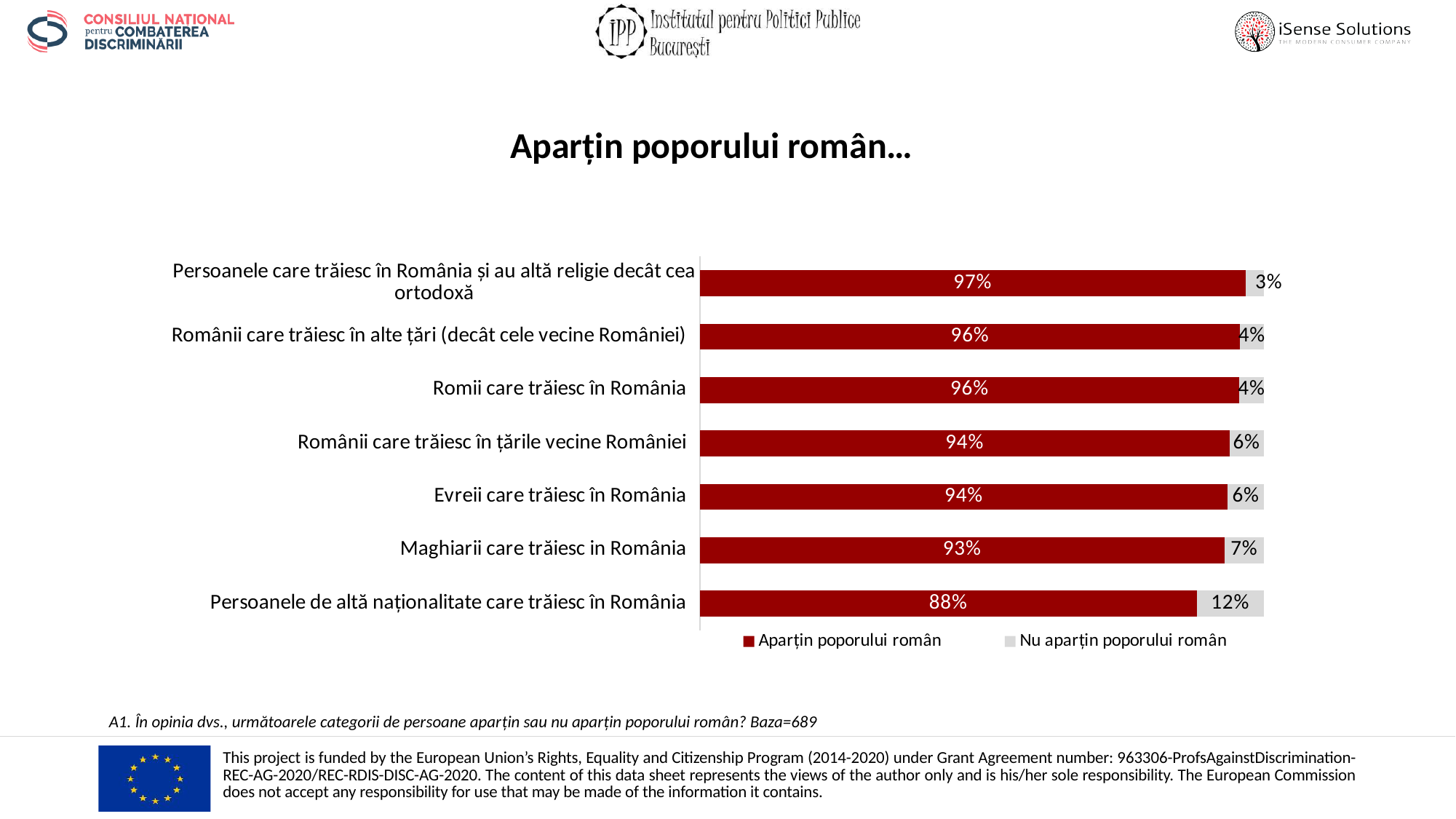
Which category has the highest 'Aparțin poporului român' value? Persoanele care trăiesc în România și au altă religie decât cea ortodoxă Which category has the lowest 'Aparțin poporului român' value? Persoanele de altă naționalitate care trăiesc în România What is the 'Nu aparțin poporului român' value for Persoanele de altă naționalitate care trăiesc în România? 12% What is the title of the chart? Aparțin poporului român... How many categories are shown in the chart? 7 What percentage of respondents say that Romii care trăiesc în România belong to the Romanian people (Aparțin poporului român)? 96% What kind of chart is shown on the slide? Stacked bar chart What is the total of the two segments for the bar for Românii care trăiesc în țările vecine României? 100% How many series does the legend list? 2 Which has a larger 'Nu aparțin poporului român' value: Maghiarii care trăiesc in România or Românii care trăiesc în alte țări (decât cele vecine României)? Maghiarii care trăiesc in România What is the 'Aparțin poporului român' value for Maghiarii care trăiesc in România? 93% What is the difference in 'Aparțin poporului român' percentage between Evreii care trăiesc în România and Persoanele de altă naționalitate care trăiesc în România? 6 percentage points